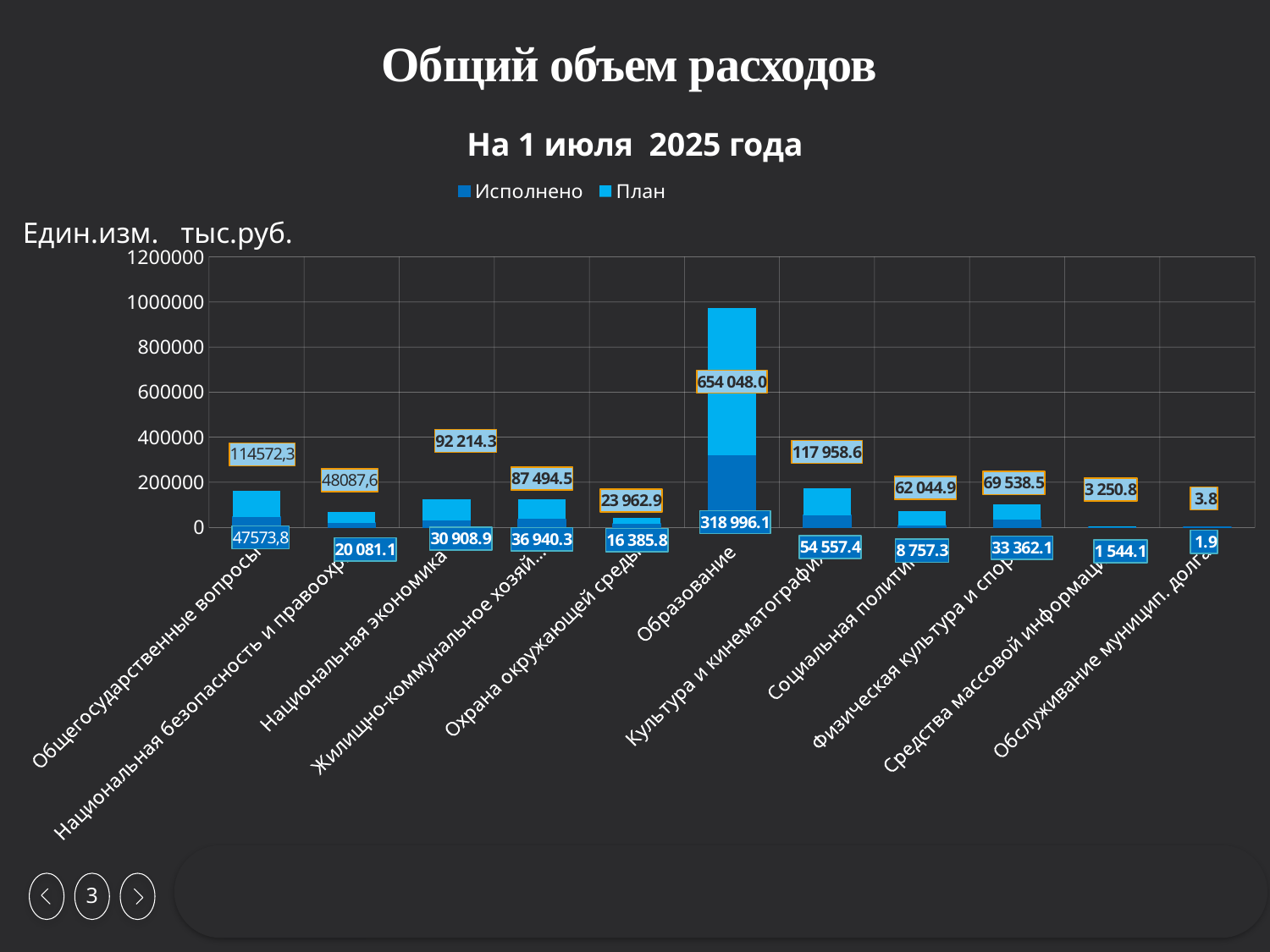
What is the total of the stacked bar for Национальная экономика? 123 123.2 What is the План value for Образование? 654 048.0 What is the Исполнено value for Образование? 318 996.1 What kind of chart is shown on the slide? Stacked bar chart Which is larger: the Исполнено value for Культура и кинематография or for Общегосударственные вопросы? Культура и кинематография What is the План value for Культура и кинематография? 117 958.6 How many categories are shown on the x axis? 11 What is the Исполнено value for Национальная экономика? 30 908.9 What is the difference between the План and Исполнено values for Образование? 335 051.9 Which category has the highest План value? Образование Which category has the lowest Исполнено value? Обслуживание муницип. долга How many series does the legend list? 2